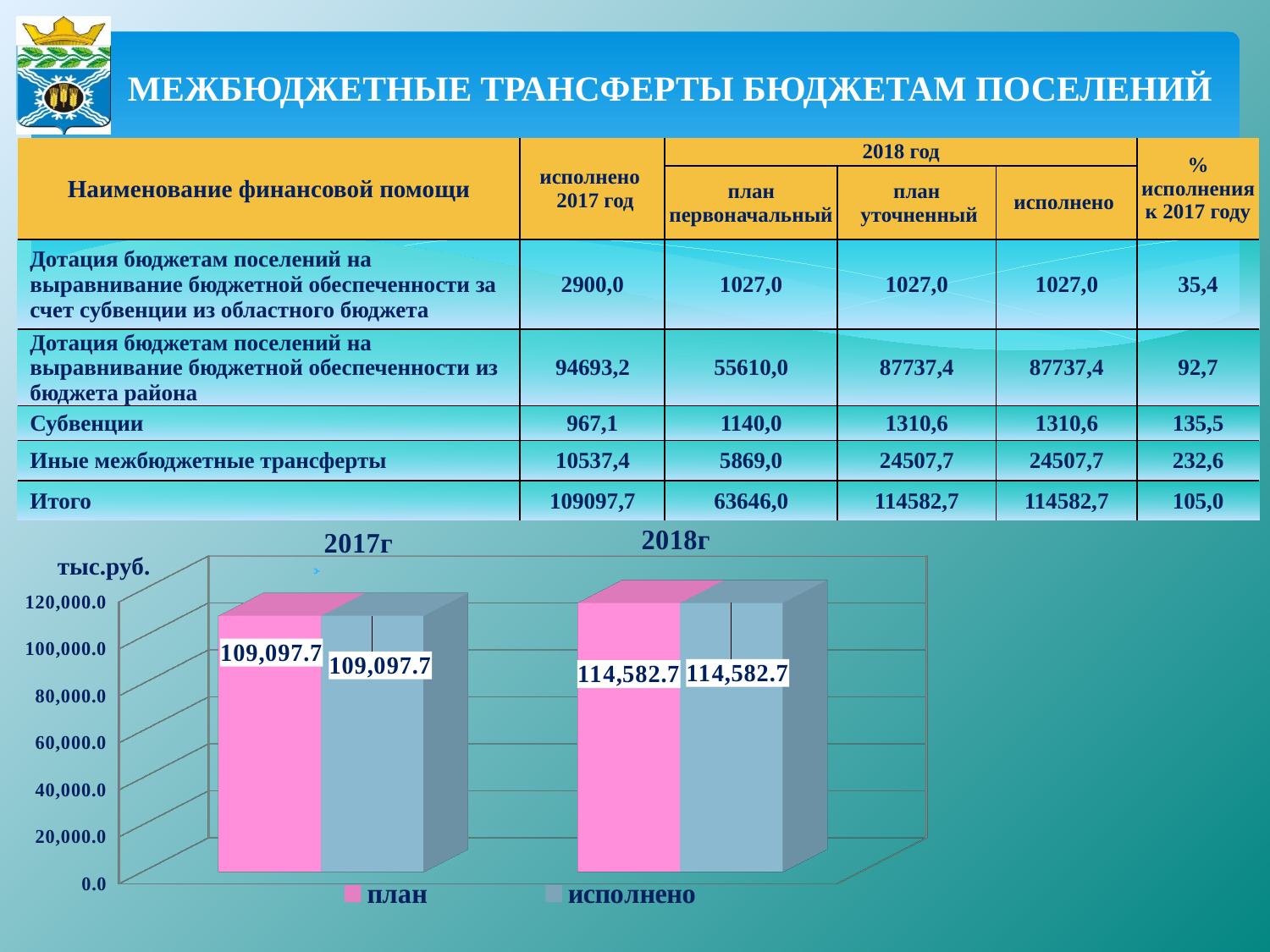
In the bar chart, what is the value of план for 2017г? 109,097.7 How many year categories are shown on the x axis of the bar chart? 2 In the bar chart, what is the value of план for 2018г? 114,582.7 In the bar chart, which year has the higher value for план, 2017г or 2018г? 2018г In the bar chart, is the value of план for 2017г greater or less than 100,000.0? greater In the bar chart, what is the difference between исполнено for 2018г and исполнено for 2017г? 5,485.0 Do the исполнено values in the bar chart rise or fall from 2017г to 2018г? rise What unit is indicated on the vertical axis of the bar chart? тыс.руб. How many series does the legend of the bar chart list? 2 What kind of chart is shown at the bottom of the slide? bar chart In the bar chart, what is the value of исполнено for 2018г? 114,582.7 In the bar chart, what is the value of исполнено for 2017г? 109,097.7